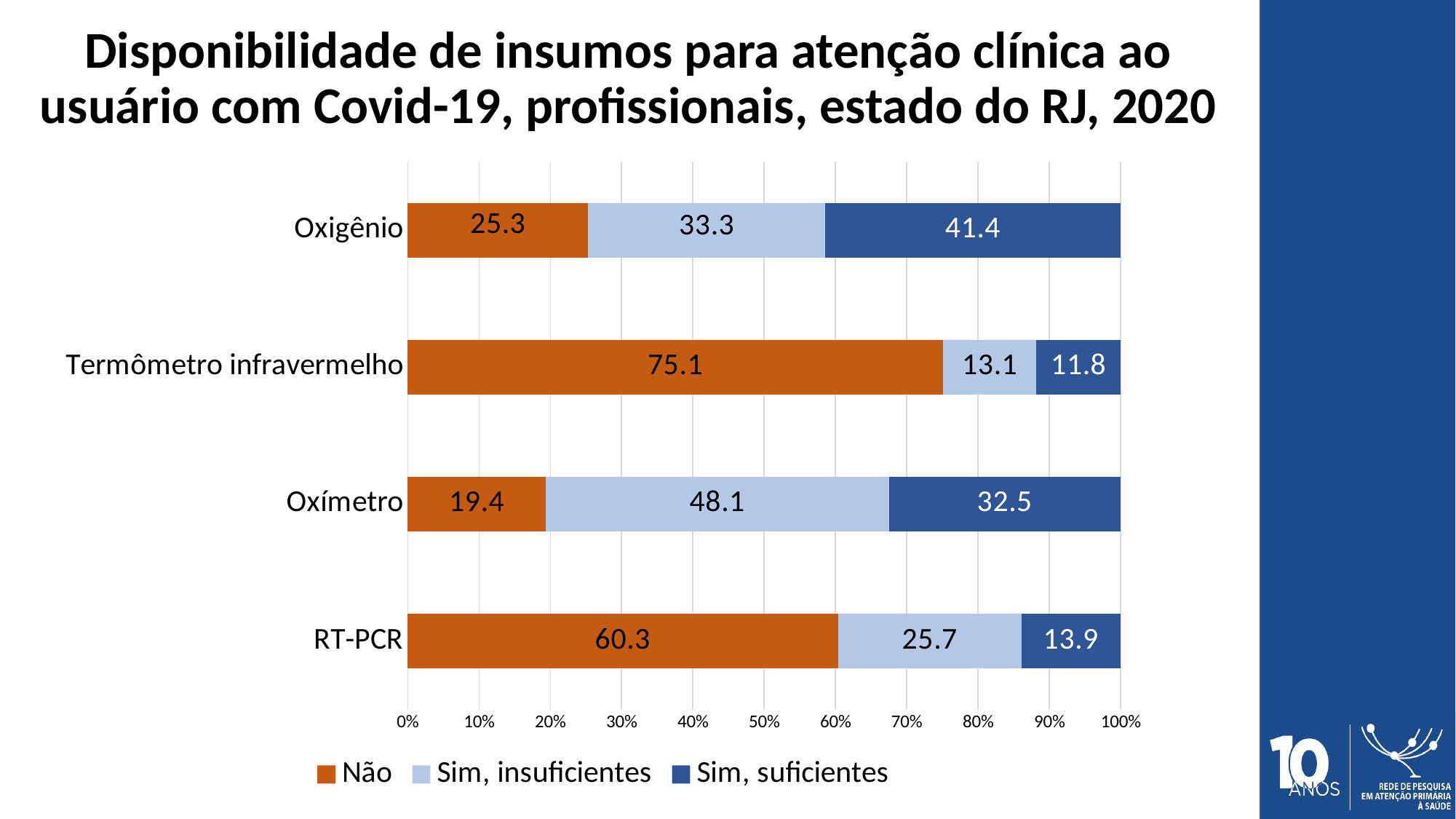
What is the value of "Não" for Termômetro infravermelho? 75.1 How many categories are shown on the chart? 4 What is the value of "Sim, suficientes" for RT-PCR? 13.9 What is the value of "Sim, insuficientes" for Oxímetro? 48.1 Which is larger: the "Sim, insuficientes" value for Oxigênio or for RT-PCR? Oxigênio Which category has the highest value for "Não"? Termômetro infravermelho Which category has the lowest value for "Sim, suficientes"? Termômetro infravermelho How many series does the legend list? 3 Which legend entry is shown in orange? Não What is the difference between the "Não" values for RT-PCR and Oxigênio? 35 What is the value of "Sim, suficientes" for Oxigênio? 41.4 What kind of chart is shown on the slide? Stacked bar chart